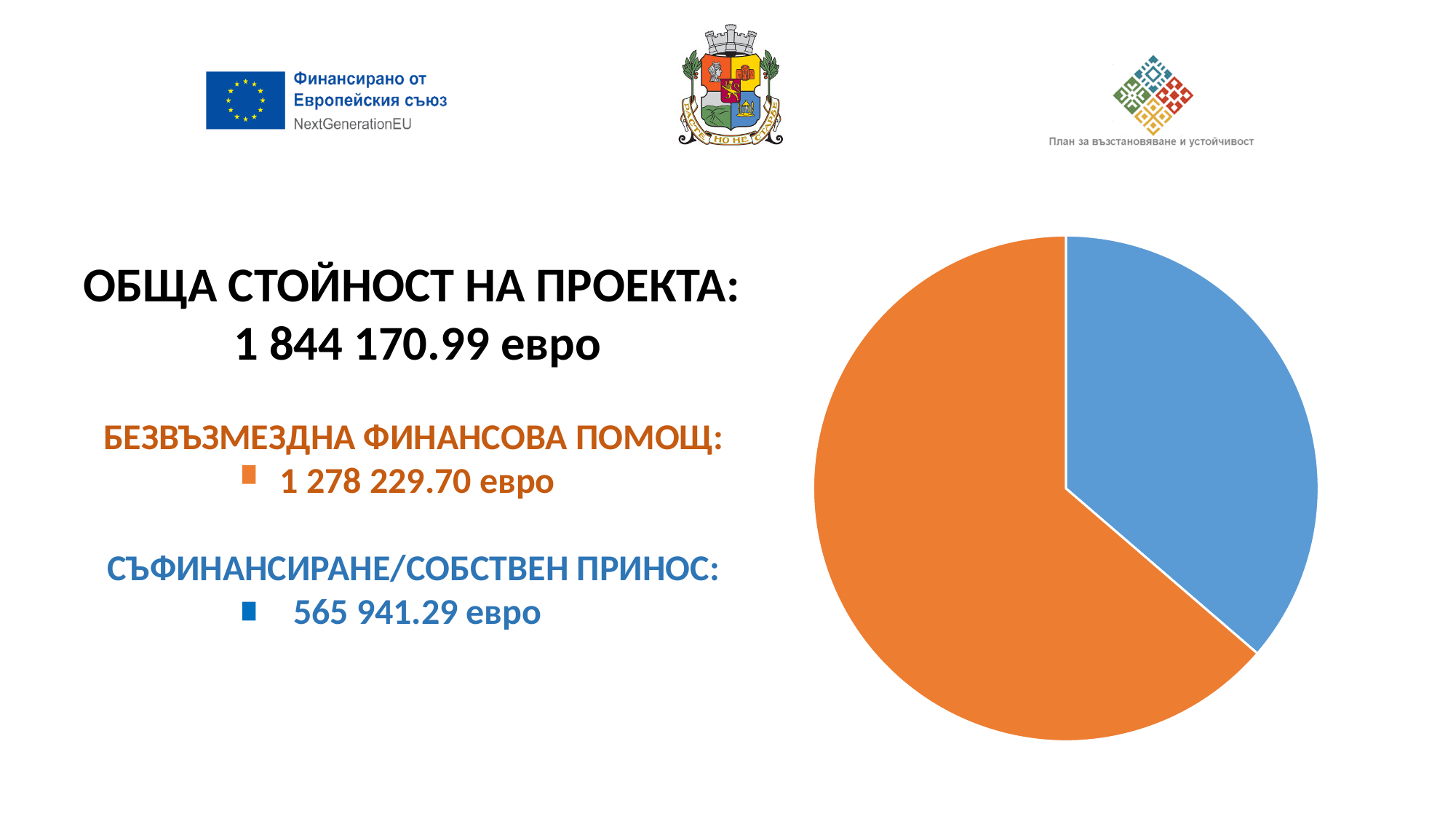
What kind of chart is shown on the slide? pie chart Which component of the project value is the smallest? СЪФИНАНСИРАНЕ/СОБСТВЕН ПРИНОС What is the value of the co-financing/own contribution (СЪФИНАНСИРАНЕ/СОБСТВЕН ПРИНОС) shown on the slide? 565 941.29 евро Which colour represents the co-financing/own contribution (СЪФИНАНСИРАНЕ/СОБСТВЕН ПРИНОС) in the pie chart? blue What is the difference between the grant and the co-financing/own contribution? 712 288.41 евро Which component of the project value is the largest? БЕЗВЪЗМЕЗДНА ФИНАНСОВА ПОМОЩ What is the total value of the project (ОБЩА СТОЙНОСТ НА ПРОЕКТА)? 1 844 170.99 евро What is the value of the grant (БЕЗВЪЗМЕЗДНА ФИНАНСОВА ПОМОЩ) shown on the slide? 1 278 229.70 евро Which is larger: the grant or the co-financing/own contribution? the grant (БЕЗВЪЗМЕЗДНА ФИНАНСОВА ПОМОЩ) Which colour represents the grant (БЕЗВЪЗМЕЗДНА ФИНАНСОВА ПОМОЩ) in the pie chart? orange How many slices does the pie chart have? 2